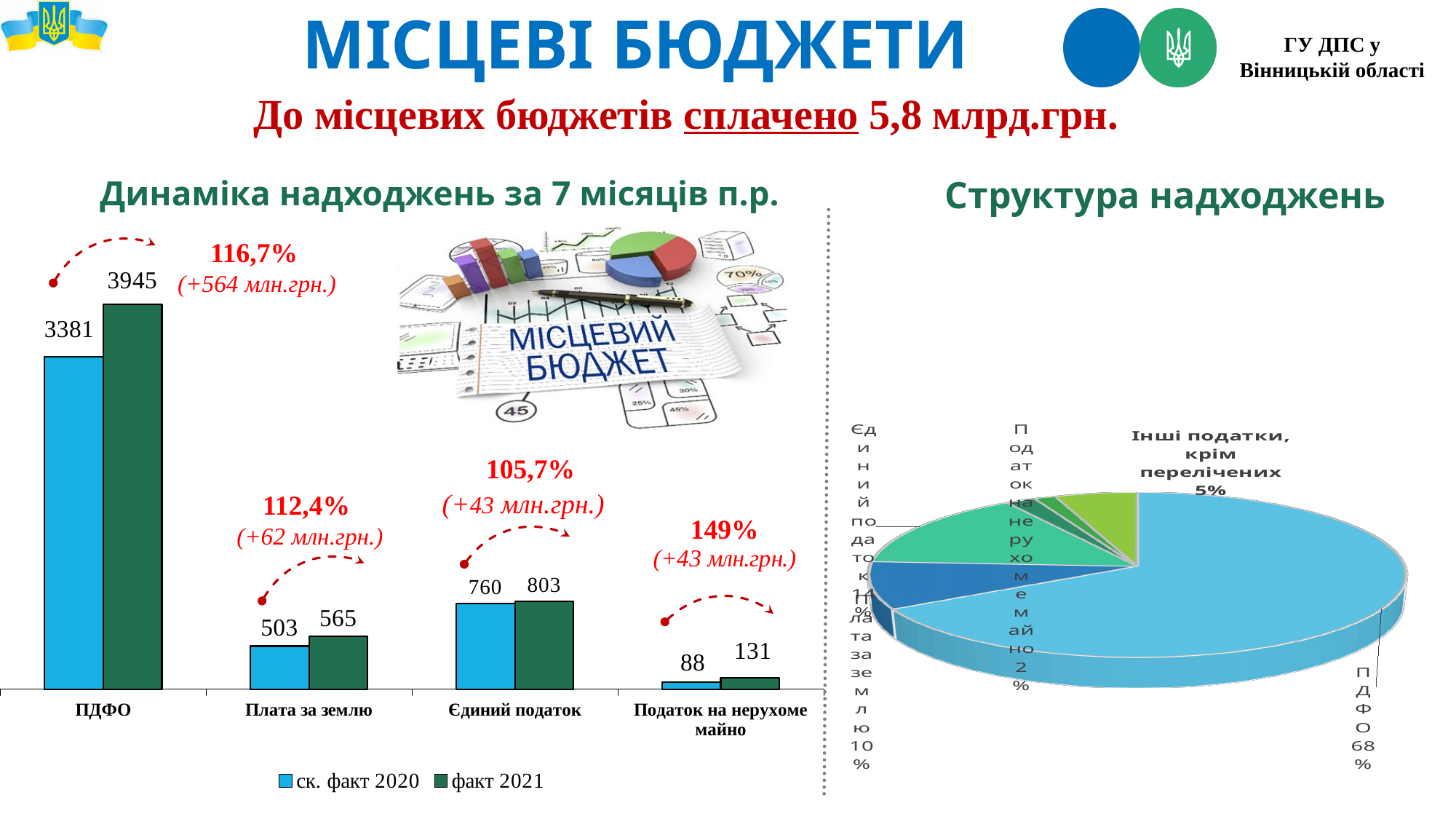
In the chart 'Динаміка надходжень за 7 місяців п.р.', what is the difference between the 'факт 2021' and 'ск. факт 2020' values for Єдиний податок? 43 In the chart 'Динаміка надходжень за 7 місяців п.р.', which is larger for Плата за землю: the 'ск. факт 2020' value or the 'факт 2021' value? факт 2021 How many categories are shown on the x axis of the chart 'Динаміка надходжень за 7 місяців п.р.'? 4 What type of chart is 'Динаміка надходжень за 7 місяців п.р.'? bar chart In the pie chart 'Структура надходжень', what share does 'Інші податки, крім перелічених' have? 5% In the chart 'Динаміка надходжень за 7 місяців п.р.', what is the value for Плата за землю in the series 'ск. факт 2020'? 503 In the chart 'Динаміка надходжень за 7 місяців п.р.', which category has the highest value in the series 'факт 2021'? ПДФО In the chart 'Динаміка надходжень за 7 місяців п.р.', what is the value for Податок на нерухоме майно in the series 'факт 2021'? 131 In the chart 'Динаміка надходжень за 7 місяців п.р.', which category has the lowest value in the series 'ск. факт 2020'? Податок на нерухоме майно In the chart 'Динаміка надходжень за 7 місяців п.р.', what is the value for ПДФО in the series 'факт 2021'? 3945 How many series does the legend of the chart 'Динаміка надходжень за 7 місяців п.р.' list? 2 In the pie chart 'Структура надходжень', what share does ПДФО have? 68%